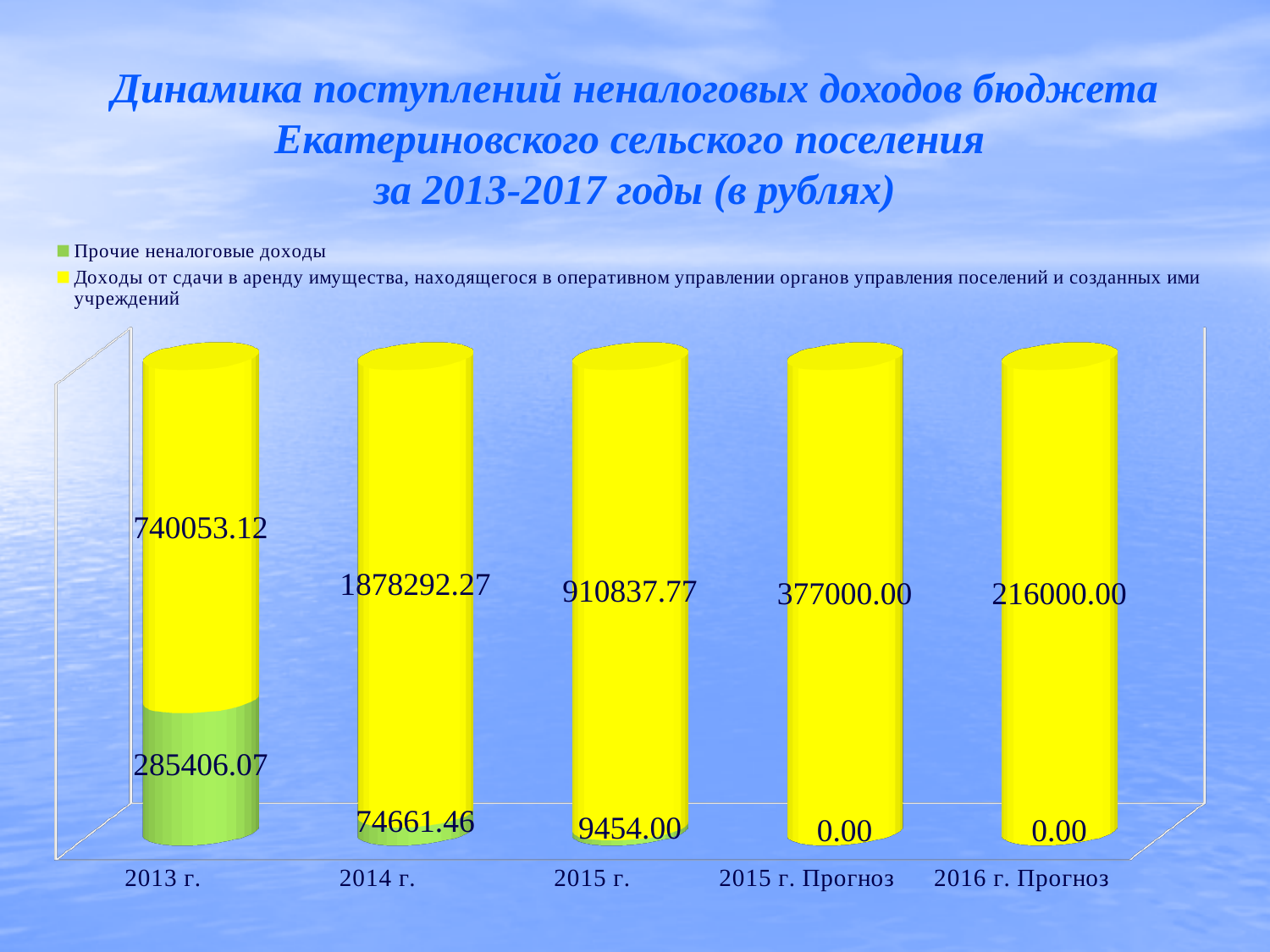
How many series does the legend list? 2 What kind of chart is shown on the slide? Stacked bar chart What is the value of 'Прочие неналоговые доходы' for 2015 г.? 9454.00 Which is larger: 'Прочие неналоговые доходы' for 2013 г. or for 2014 г.? 2013 г. Which category has the highest value for 'Доходы от сдачи в аренду имущества...'? 2014 г. Which category has the highest value for 'Прочие неналоговые доходы'? 2013 г. What is the value of 'Доходы от сдачи в аренду имущества...' for 2014 г.? 1878292.27 What is the difference between the 'Доходы от сдачи в аренду имущества...' values for 2014 г. and 2015 г.? 967454.50 What is the value of 'Доходы от сдачи в аренду имущества...' for 2016 г. Прогноз? 216000.00 What is the total of the stacked bar for 2013 г.? 1025459.19 How many categories are shown on the x axis? 5 What is the value of 'Прочие неналоговые доходы' for 2013 г.? 285406.07